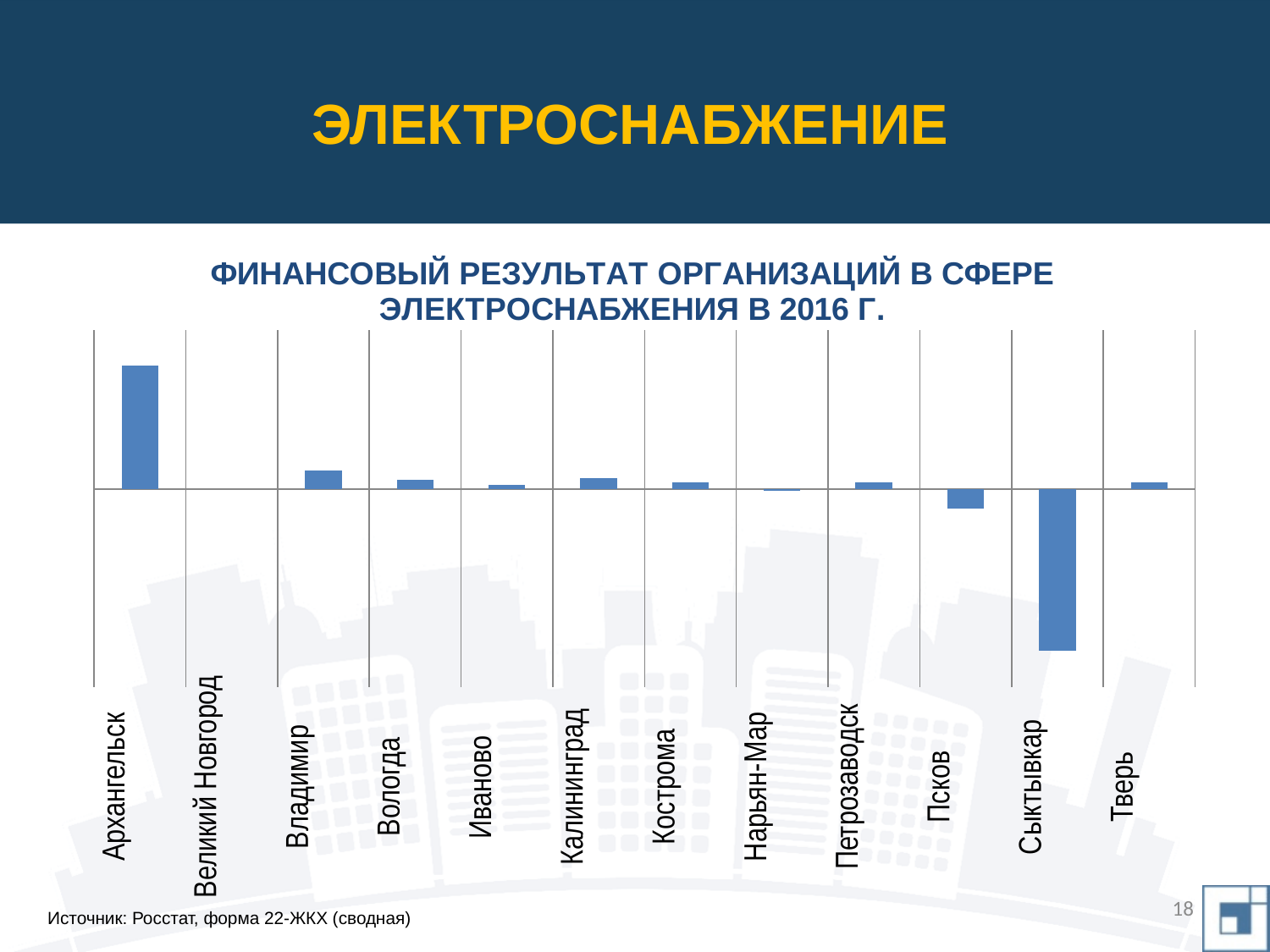
What year does the chart title say the data refers to? 2016 Which city has the highest financial result in the chart? Архангельск What source is cited for the chart data? Росстат, форма 22-ЖКХ (сводная) Which has the larger value, Владимир or Вологда? Владимир Which has the larger value, Архангельск or Владимир? Архангельск Which city has the lowest financial result in the chart? Сыктывкар Which has the larger value, Тверь or Сыктывкар? Тверь What kind of chart is shown on the slide? Bar chart How many cities are shown on the x axis of the chart? 12